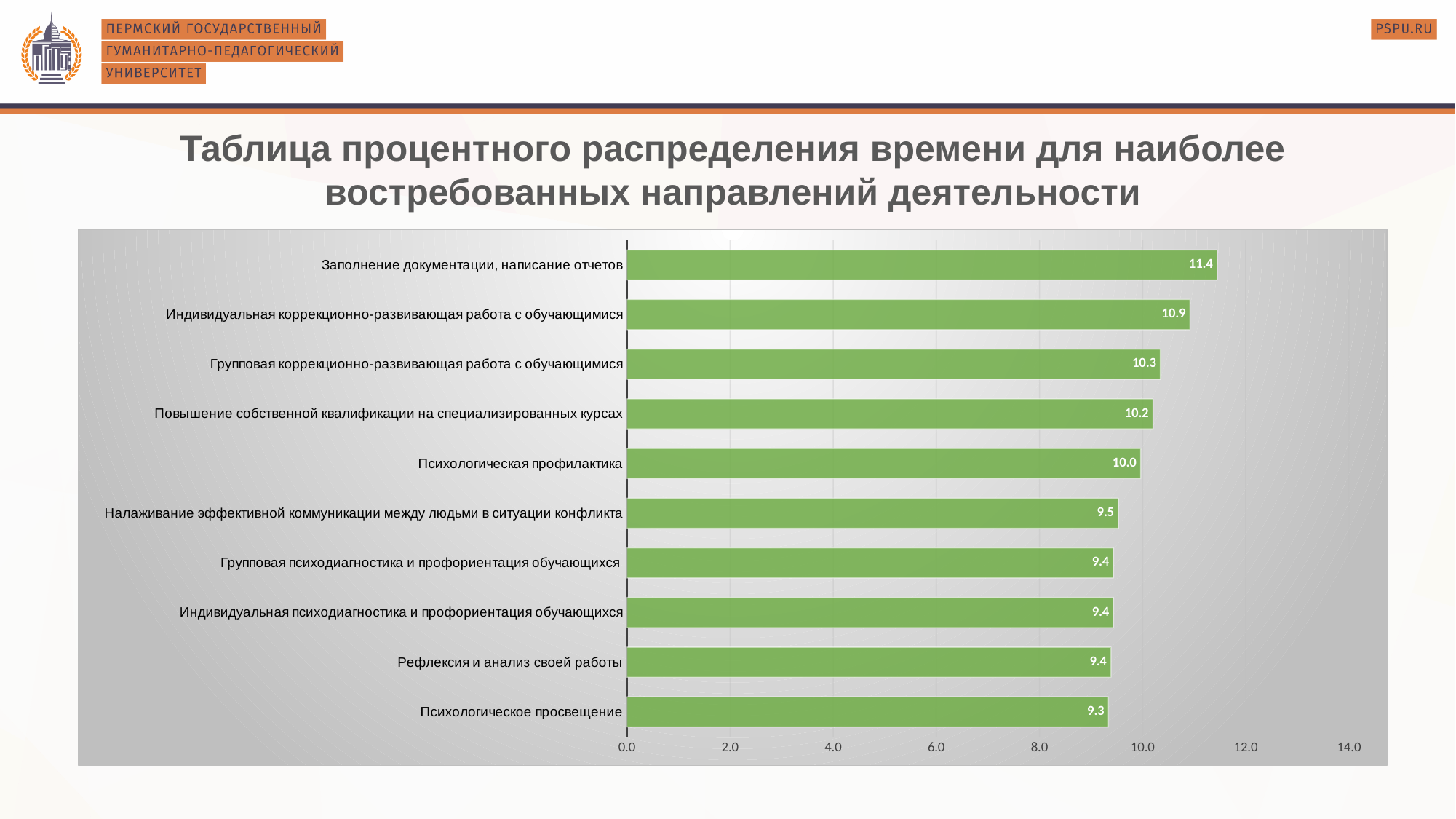
Which is larger: the value for "Индивидуальная коррекционно-развивающая работа с обучающимися" or for "Групповая коррекционно-развивающая работа с обучающимися"? Индивидуальная коррекционно-развивающая работа с обучающимися What is the maximum value shown on the horizontal axis? 14.0 What value is shown for "Повышение собственной квалификации на специализированных курсах"? 10.2 What kind of chart is shown on the slide? bar chart Which category has the highest value? Заполнение документации, написание отчетов What is the difference between the values for "Заполнение документации, написание отчетов" and "Психологическое просвещение"? 2.1 Is the value for "Налаживание эффективной коммуникации между людьми в ситуации конфликта" greater or less than 10.0? less What value is shown for "Психологическая профилактика"? 10.0 Which category has the lowest value? Психологическое просвещение What value is shown for "Психологическое просвещение"? 9.3 What value is shown for "Заполнение документации, написание отчетов"? 11.4 How many categories are shown in the chart? 10